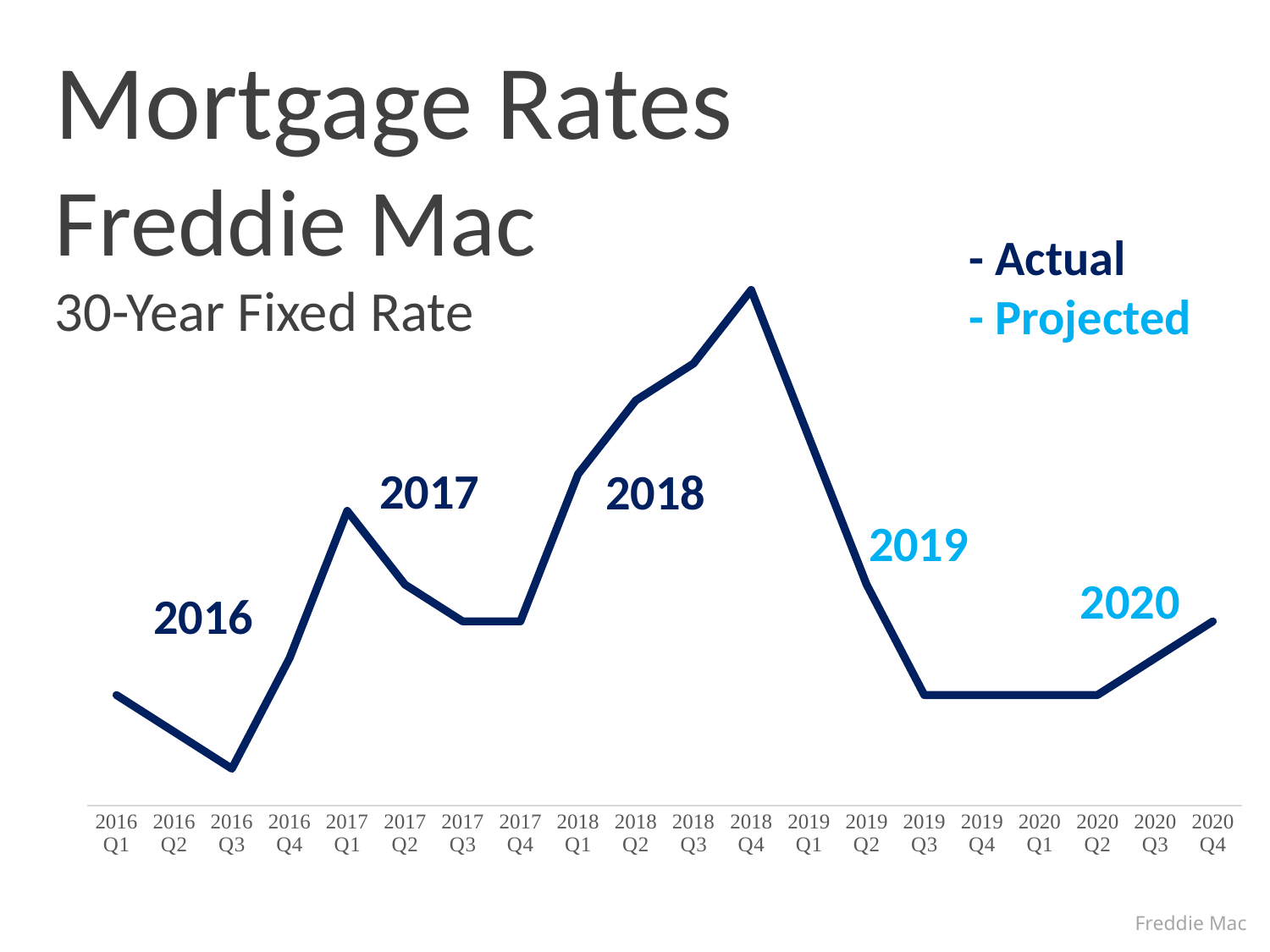
Does the mortgage rate rise or fall from 2017 Q4 to 2018 Q4? rise What kind of chart is shown on the slide? line chart How many quarterly points are plotted along the x axis? 20 Which quarter has the highest mortgage rate on the chart? 2018 Q4 What is the source cited at the bottom of the chart? Freddie Mac Does the mortgage rate rise or fall from 2020 Q2 to 2020 Q4? rise Does the mortgage rate rise or fall from 2018 Q4 to 2019 Q3? fall Which is higher, the rate in 2018 Q4 or the rate in 2019 Q3? 2018 Q4 Which quarter has the lowest mortgage rate on the chart? 2016 Q3 What are the two entries in the chart's legend? Actual and Projected How many entries does the legend list? 2 Which is higher, the rate in 2017 Q1 or the rate in 2016 Q3? 2017 Q1